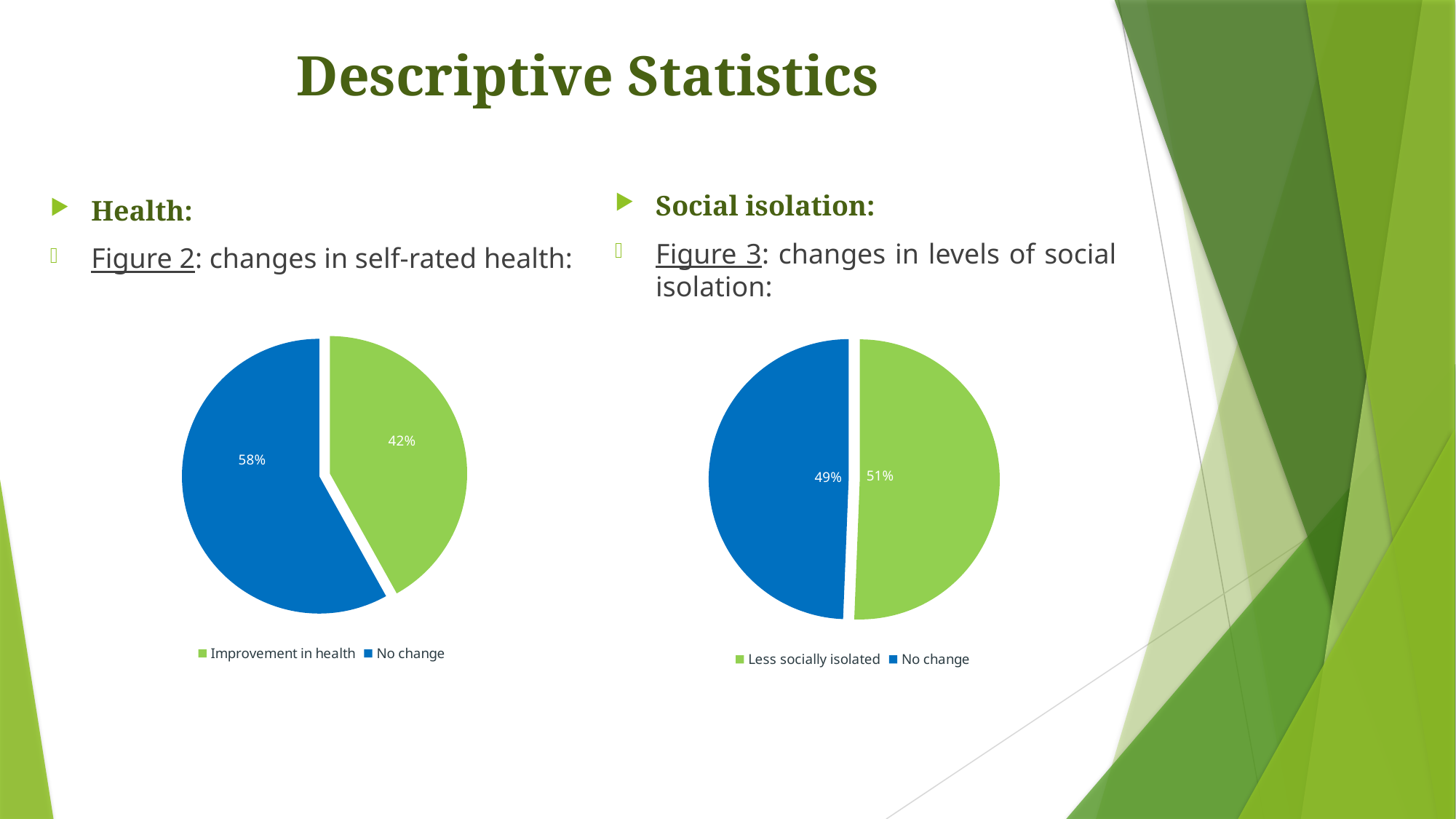
In the left pie chart (Figure 2), which category has the smaller slice? Improvement in health In the right pie chart (Figure 3), what colour is the 'No change' slice? Blue In the right pie chart (Figure 3: changes in levels of social isolation), what share is labelled for 'No change'? 49% In the right pie chart (Figure 3: changes in levels of social isolation), what share is labelled for 'Less socially isolated'? 51% In the left pie chart (Figure 2: changes in self-rated health), what share is labelled for 'Improvement in health'? 42% In the left pie chart (Figure 2: changes in self-rated health), what share is labelled for 'No change'? 58% What type of chart is used for Figure 2 on the left? Pie chart In the right pie chart (Figure 3), what is the difference in percentage points between 'Less socially isolated' and 'No change'? 2 In the left pie chart (Figure 2), is the share for 'No change' greater or less than 50%? greater How many categories does the legend of the right pie chart (Figure 3) list? 2 In the left pie chart (Figure 2), which category has the larger slice? No change In the left pie chart (Figure 2), what is the difference in percentage points between 'No change' and 'Improvement in health'? 16